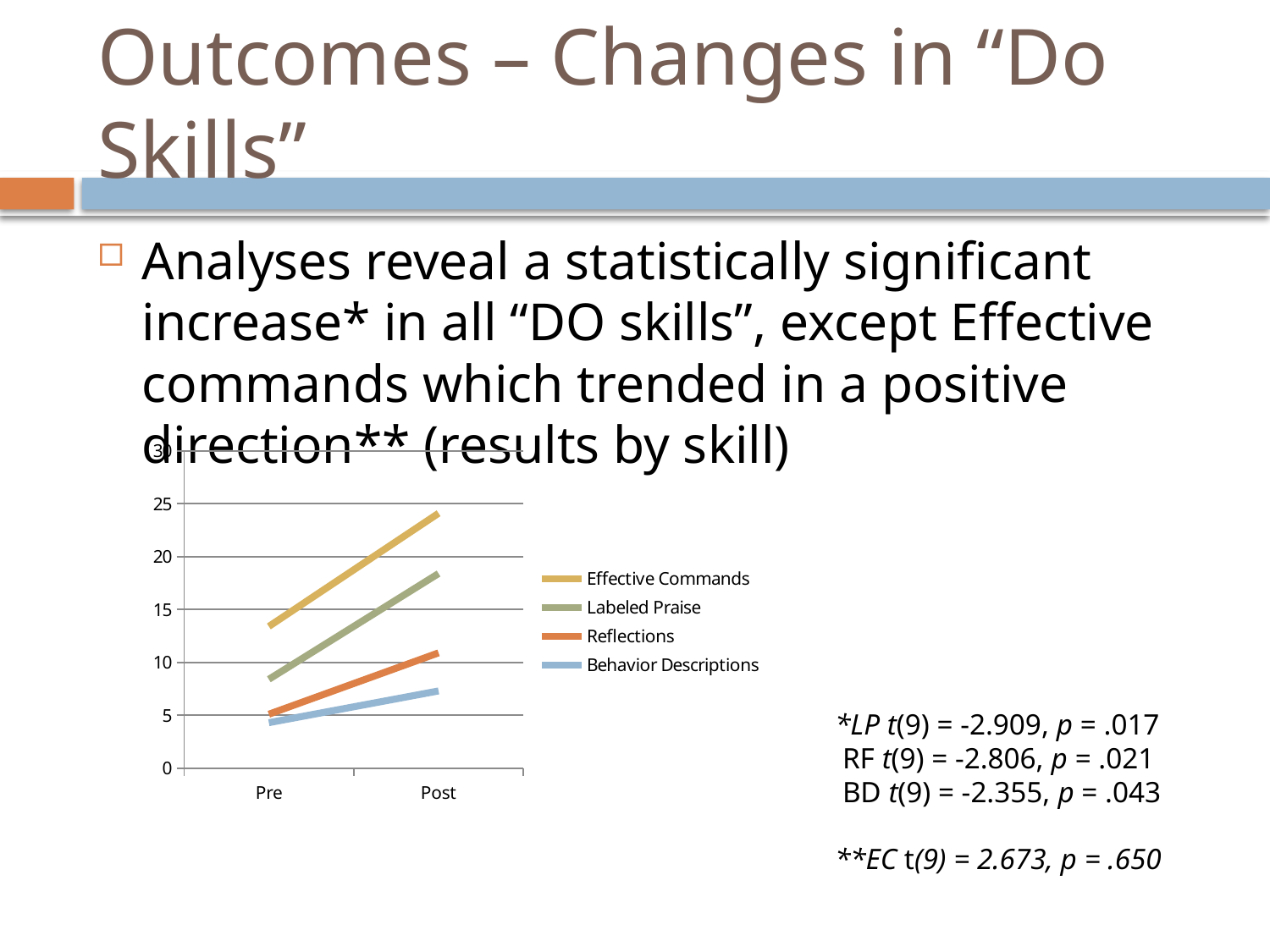
Do the values for Effective Commands rise or fall from Pre to Post? rise Which series has the highest value at Pre? Effective Commands Is the value for Behavior Descriptions at Post greater or less than 10? less Is the value for Effective Commands at Post greater or less than 20? greater Which series has the highest value at Post? Effective Commands Which series has the lowest value at Post? Behavior Descriptions How many categories are shown on the x axis of the chart? 2 Is the value for Labeled Praise at Pre greater or less than 10? less What kind of chart is shown on the slide? line chart What colour is the line for Reflections in the chart? orange How many series does the chart's legend list? 4 Which is larger at Post: Labeled Praise or Reflections? Labeled Praise